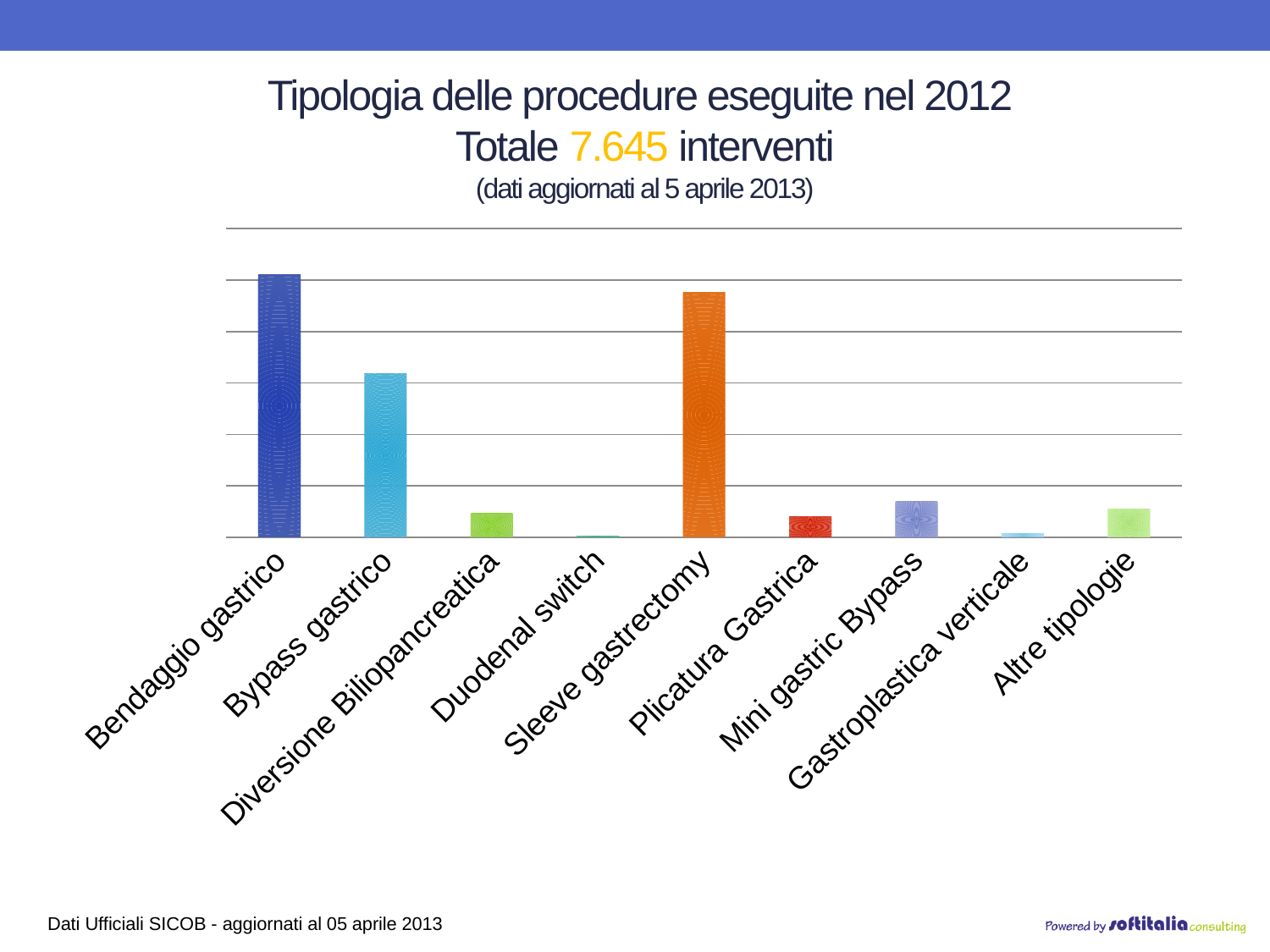
Which bar is taller: Bypass gastrico or Sleeve gastrectomy? Sleeve gastrectomy Which procedure has the tallest bar in the chart? Bendaggio gastrico Which procedure has the second tallest bar in the chart? Sleeve gastrectomy Which bar is taller: Mini gastric Bypass or Plicatura Gastrica? Mini gastric Bypass How many procedure categories are shown on the x axis of the chart? 9 Which procedure has the shortest bar in the chart? Duodenal switch Which bar is taller: Bendaggio gastrico or Sleeve gastrectomy? Bendaggio gastrico What kind of chart is shown on the slide? bar chart What is the title of the chart on the slide? Tipologia delle procedure eseguite nel 2012 According to the slide title, what is the total number of interventions in 2012? 7.645